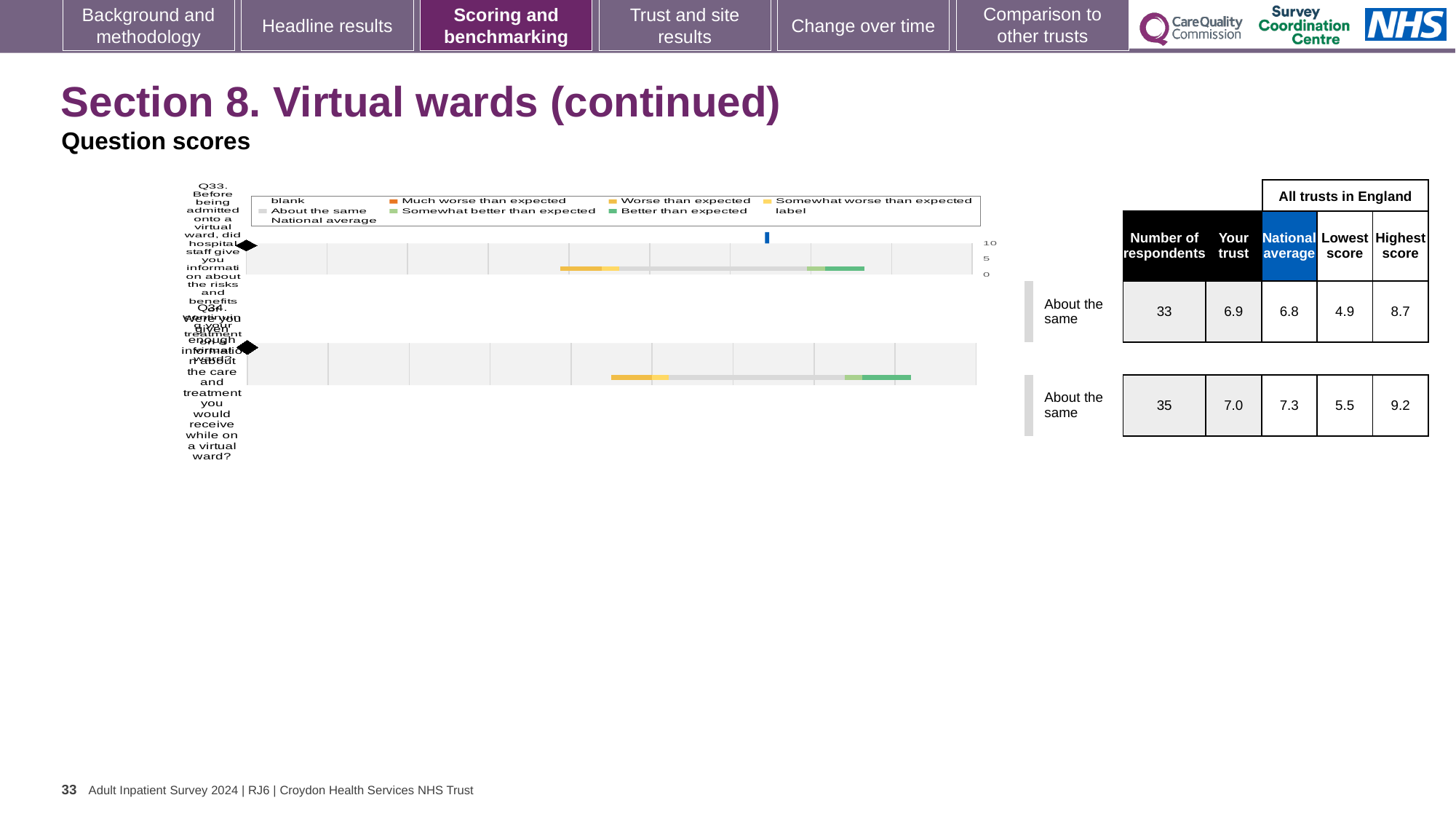
For Q33, which is larger: the 'Your trust' score or the national average? Your trust How many respondents answered Q33? 33 What is the lowest score across all trusts in England for Q33? 4.9 How many questions are plotted on the chart? 2 What is the national average score for Q34? 7.3 What kind of chart is shown on the slide? Bar chart What benchmark category is shown next to the Q34 bar? About the same For Q34, which is larger: the 'Your trust' score or the national average? National average What is the difference between the highest and lowest scores for Q33? 3.8 What is the 'Your trust' score for Q33? 6.9 What is the difference between the highest and lowest scores for Q34? 3.7 What is the highest score across all trusts in England for Q34? 9.2